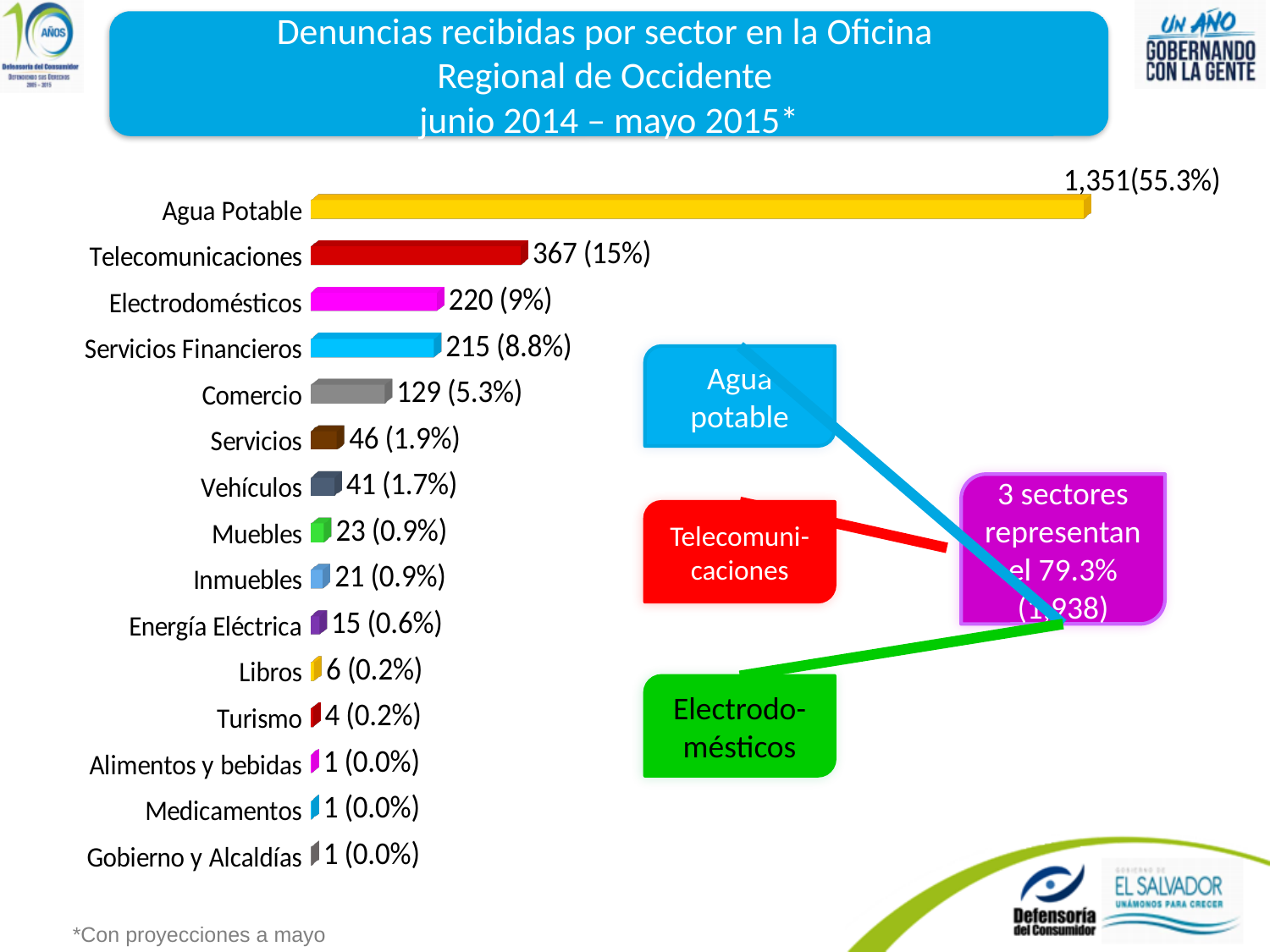
What is the combined total of the three largest sectors (Agua Potable, Telecomunicaciones and Electrodomésticos)? 1,938 What percentage share is shown for Telecomunicaciones? 15% How many sectors (categories) are shown in the chart? 15 What value is shown for Comercio? 129 What is the difference between the values for Telecomunicaciones and Electrodomésticos? 147 Which sector has the highest number of complaints? Agua Potable How many complaints (denuncias) were received for Agua Potable? 1,351 What kind of chart is shown on the slide? bar chart Do the values increase or decrease going from the top category to the bottom category? decrease What value is shown for Servicios Financieros? 215 What percentage is shown for Energía Eléctrica? 0.6% Which has a larger value, Servicios or Vehículos? Servicios